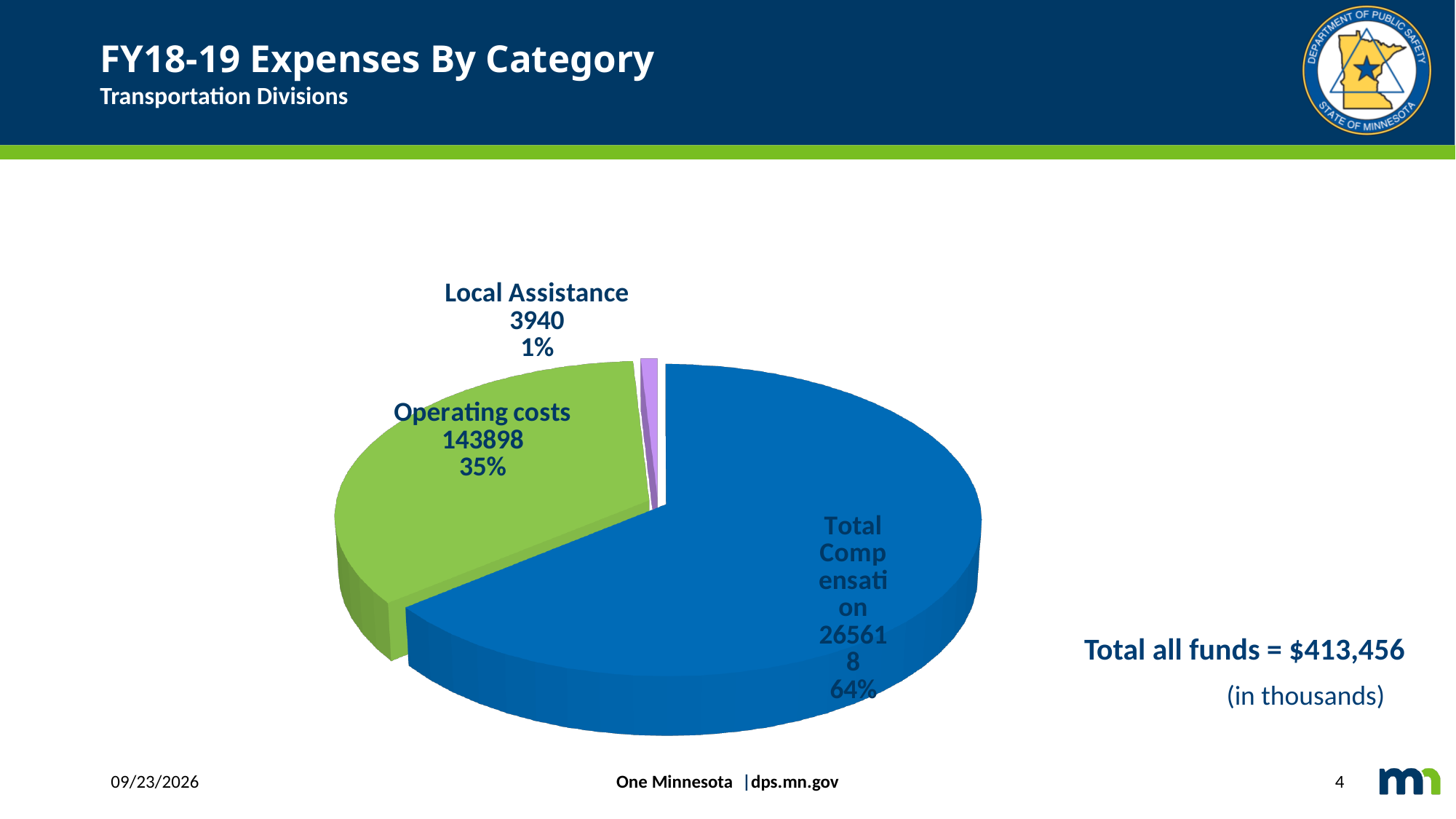
What is the difference between the values for Total Compensation and Operating costs? 121720 What share of the pie does Local Assistance represent? 1% What share of the pie does Operating costs represent? 35% What share of the pie does Total Compensation represent? 64% How many categories does the pie chart show? 3 Which is larger, the value for Operating costs or the value for Local Assistance? Operating costs Which category has the smallest slice of the pie? Local Assistance What is the value for Local Assistance? 3940 What is the value for Total Compensation? 265618 What is the value for Operating costs? 143898 What kind of chart is shown on the slide? pie chart Which category has the largest slice of the pie? Total Compensation